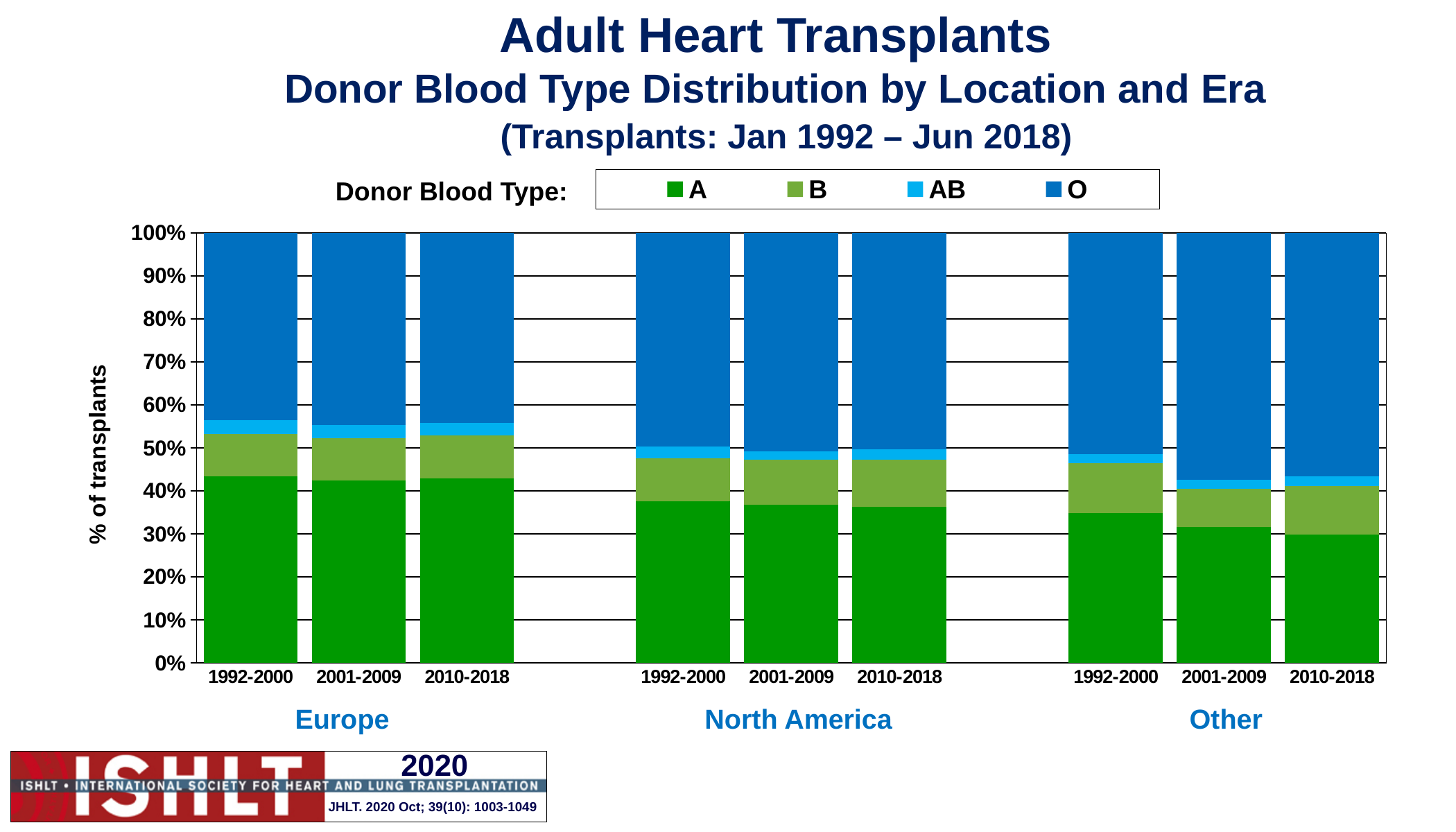
Is the share of blood type A donors for Other 2010-2018 greater or less than 40%? less Is the share of blood type A donors for North America 1992-2000 greater or less than 40%? less How many bars are plotted in the chart? 9 How many donor blood type series does the legend list? 4 How many eras are shown for each location? 3 Is the share of blood type A donors for Europe 1992-2000 greater or less than 40%? greater Which location has the largest share of blood type A donors across all eras? Europe Which has a larger share of blood type A donors: Europe 1992-2000 or Other 2010-2018? Europe 1992-2000 Which has a larger share of blood type O donors: Other 2010-2018 or Europe 2010-2018? Other 2010-2018 What kind of chart is shown on the slide? Stacked bar chart What is the label on the y axis? % of transplants For the Other location, does the share of blood type A donors rise or fall from 1992-2000 to 2010-2018? fall